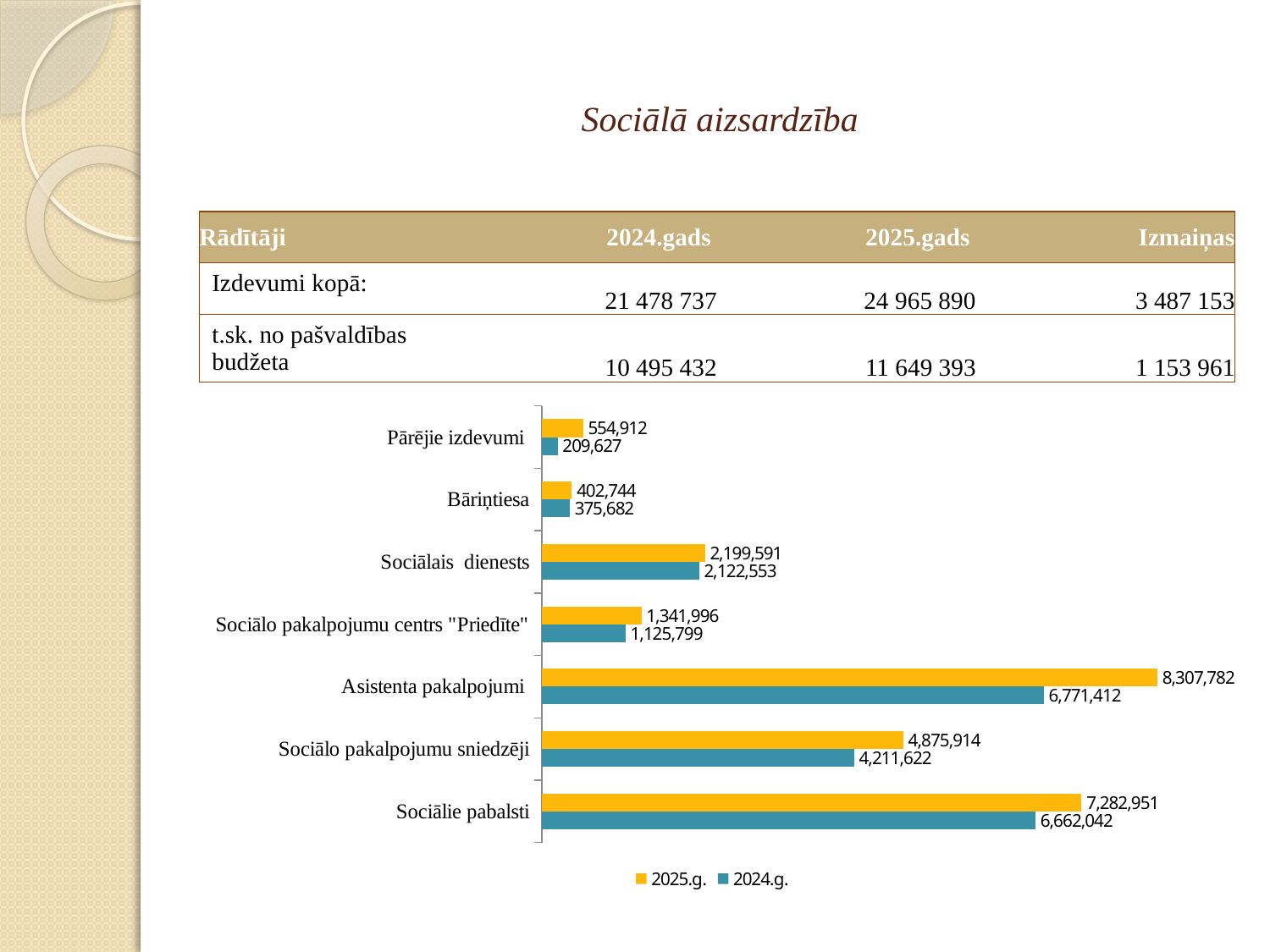
Which category has the lowest 2024.g. value? Pārējie izdevumi Which category has the highest 2025.g. value? Asistenta pakalpojumi What is the 2025.g. value for Sociālo pakalpojumu centrs "Priedīte"? 1,341,996 Which is larger: the 2025.g. value for Sociālie pabalsti or the 2025.g. value for Sociālo pakalpojumu sniedzēji? Sociālie pabalsti What is the 2025.g. value for Asistenta pakalpojumi? 8,307,782 How many categories are shown in the chart? 7 What is the difference between the 2025.g. and 2024.g. values for Asistenta pakalpojumi? 1,536,370 How many series does the chart legend list? 2 What is the difference between the 2025.g. and 2024.g. values for Pārējie izdevumi? 345,285 Which category has the lowest 2025.g. value? Bāriņtiesa What is the 2024.g. value for Sociālie pabalsti? 6,662,042 What is the 2024.g. value for Bāriņtiesa? 375,682